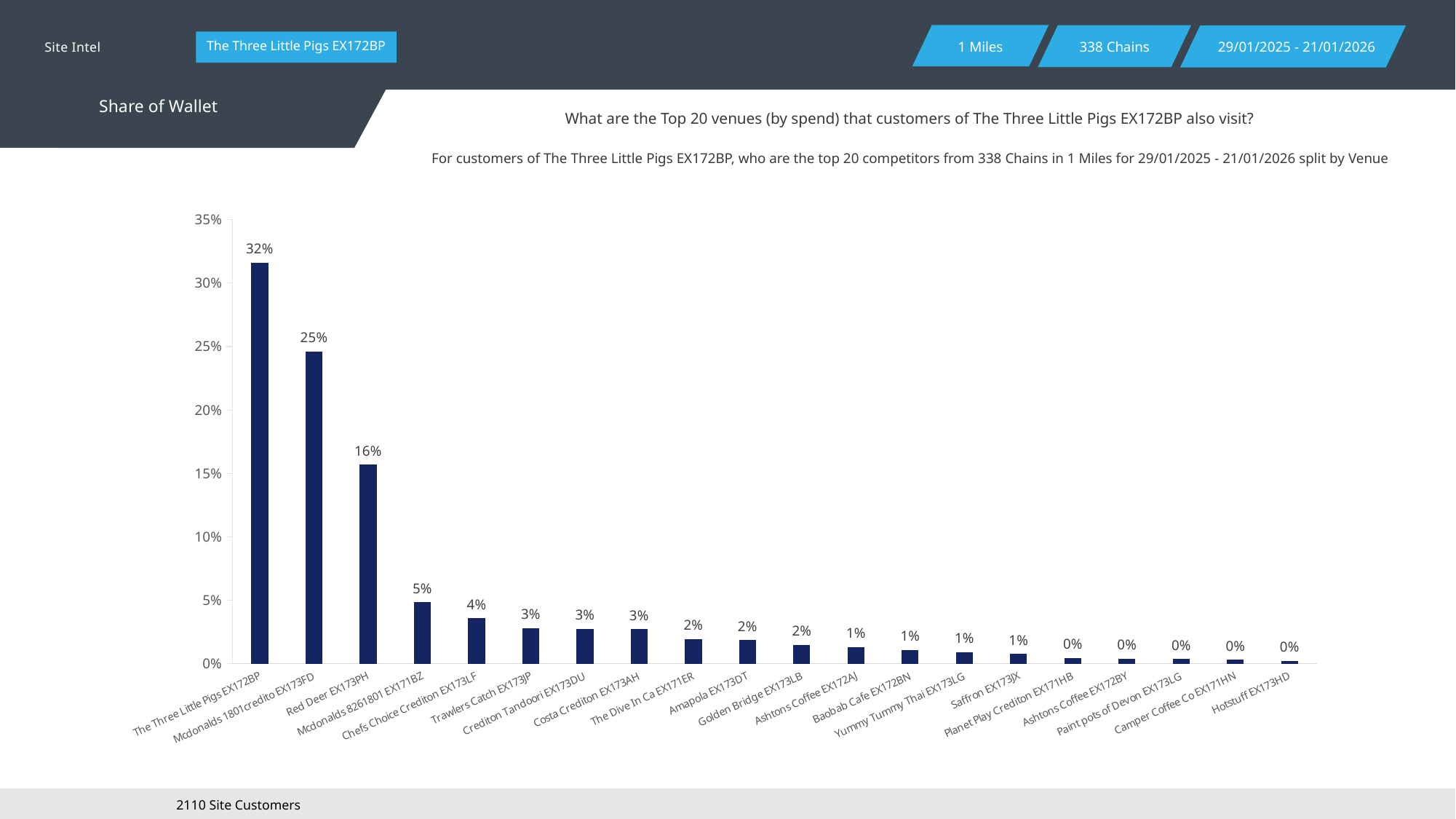
Is the value for Red Deer EX173PH greater or less than 10%? greater Which venue has the highest value? The Three Little Pigs EX172BP What is the value for The Three Little Pigs EX172BP? 32% What kind of chart is shown on the slide? bar chart Which is larger, the value for Red Deer EX173PH or Mcdonalds 8261801 EX171BZ? Red Deer EX173PH What is the highest value shown on the vertical axis? 35% Do the values rise or fall from left to right along the x axis? fall How many venues are shown on the chart? 20 What is the difference between the values for The Three Little Pigs EX172BP and Mcdonalds 1801credito EX173FD? 7% What is the value for Red Deer EX173PH? 16% What is the value for Golden Bridge EX173LB? 2% What is the value for Chefs Choice Crediton EX173LF? 4%